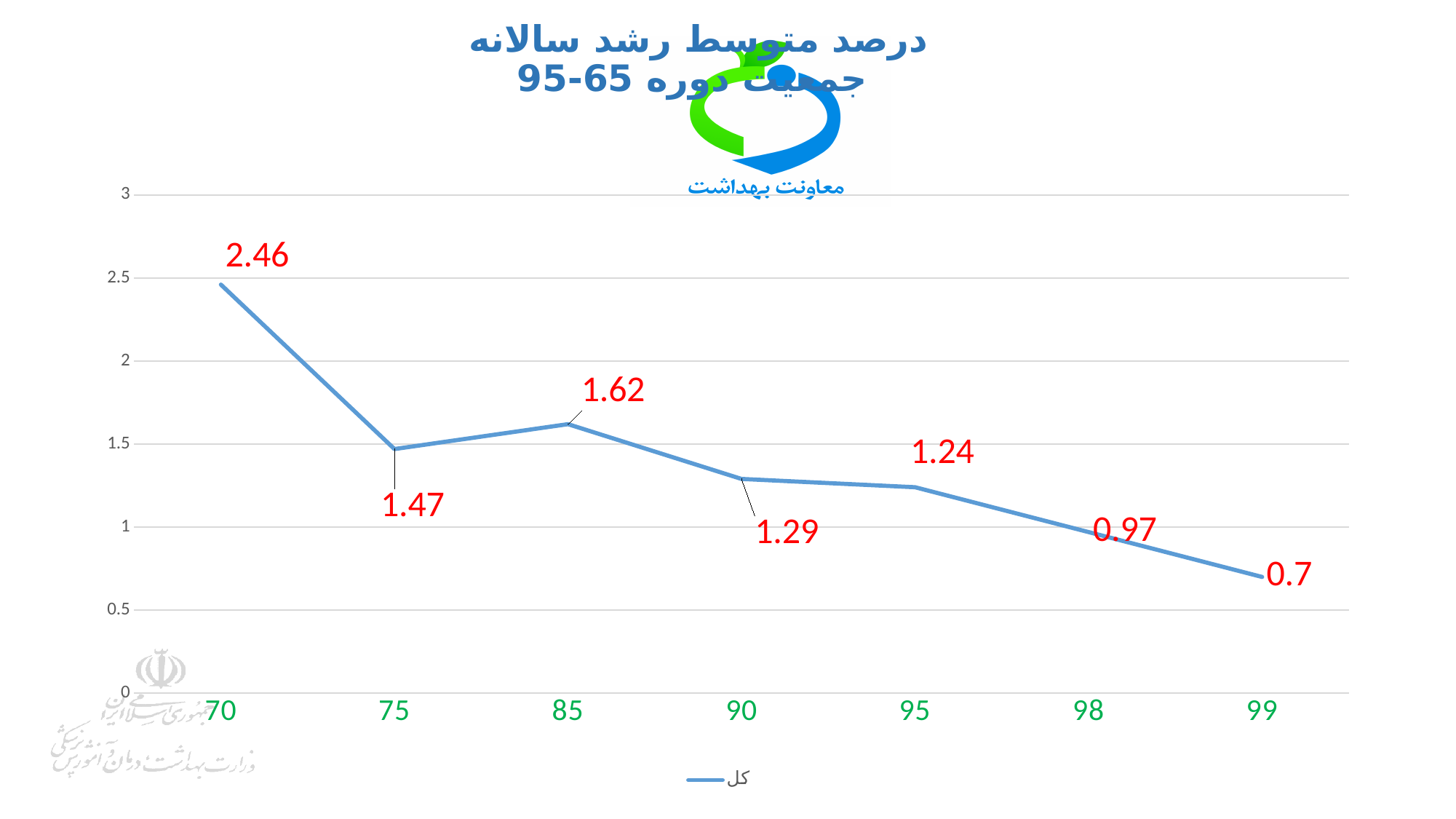
What is the overall trend of the values from 70 to 99? falling What is the difference between the values for 70 and 75? 0.99 What is the value plotted for 99? 0.7 Which has the larger value, 75 or 85? 85 Is the value for 98 greater or less than 1? less Which x-axis category has the highest value? 70 Which x-axis category has the lowest value? 99 How many data points are plotted on the line? 7 What type of chart is shown on the slide? line chart How many series does the legend list? 1 What is the value plotted for 85? 1.62 What is the value plotted for 70? 2.46